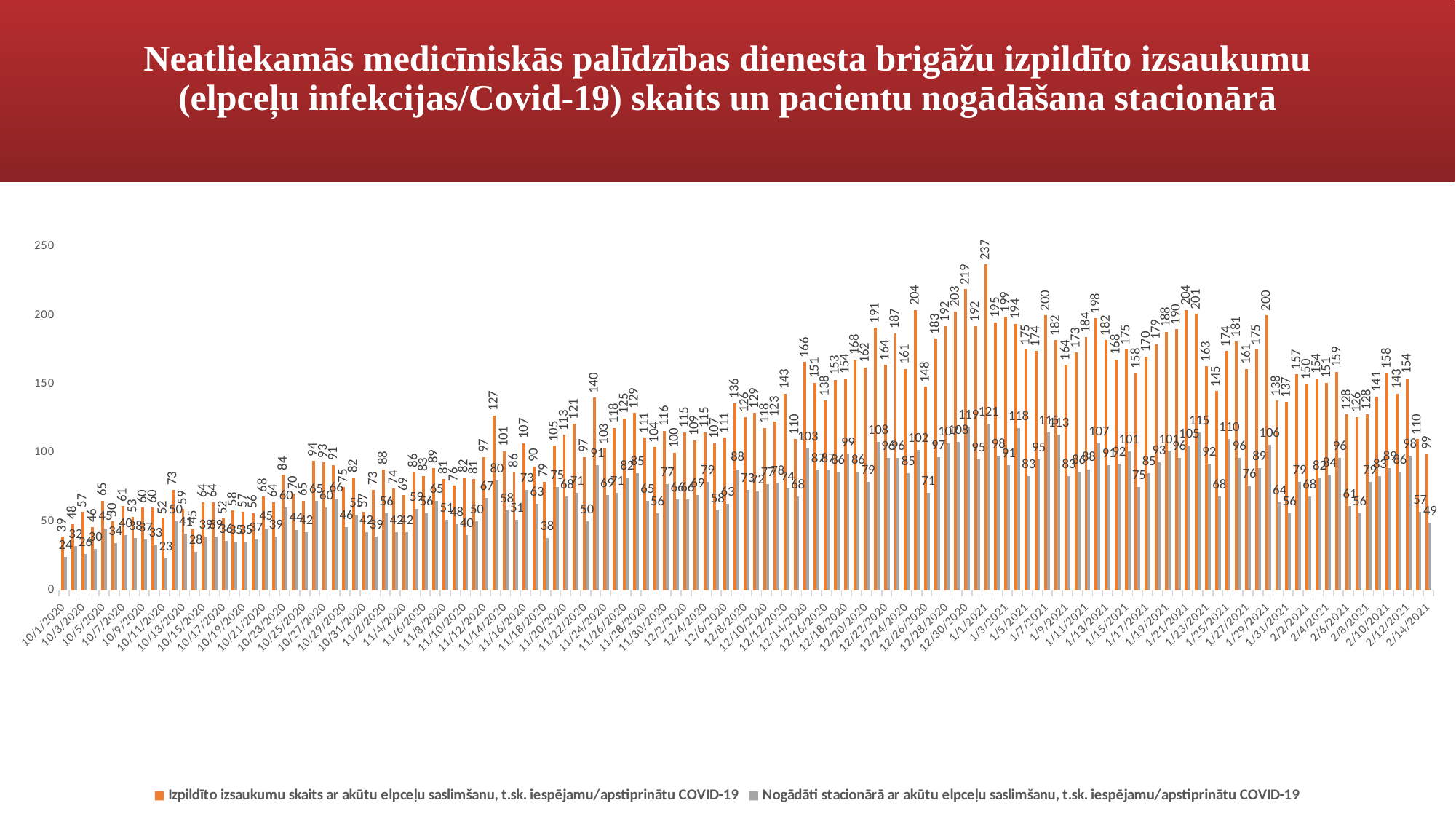
Is the highest orange bar in the chart greater or less than 200? greater What is the value of the grey series (Nogādāti stacionārā) on 10/1/2020? 24 What is the value of the orange series (Izpildīto izsaukumu skaits) on 10/1/2020? 39 Do the orange values generally rise or fall from October 2020 to the start of January 2021? rise What is the highest value reached by the orange series (Izpildīto izsaukumu skaits) in the chart? 237 What is the difference between the orange and grey values on 10/1/2020? 15 What colour represents the series 'Nogādāti stacionārā ar akūtu elpceļu saslimšanu' in the legend? grey What is the value of the grey series (Nogādāti stacionārā) on 2/14/2021, the last date on the chart? 49 On 2/14/2021, which series has the larger value, the orange (Izpildīto izsaukumu skaits) or the grey (Nogādāti stacionārā)? orange (Izpildīto izsaukumu skaits) What kind of chart is shown on the slide? bar chart How many series does the legend list? 2 What is the value of the orange series (Izpildīto izsaukumu skaits) on 2/14/2021, the last date on the chart? 99